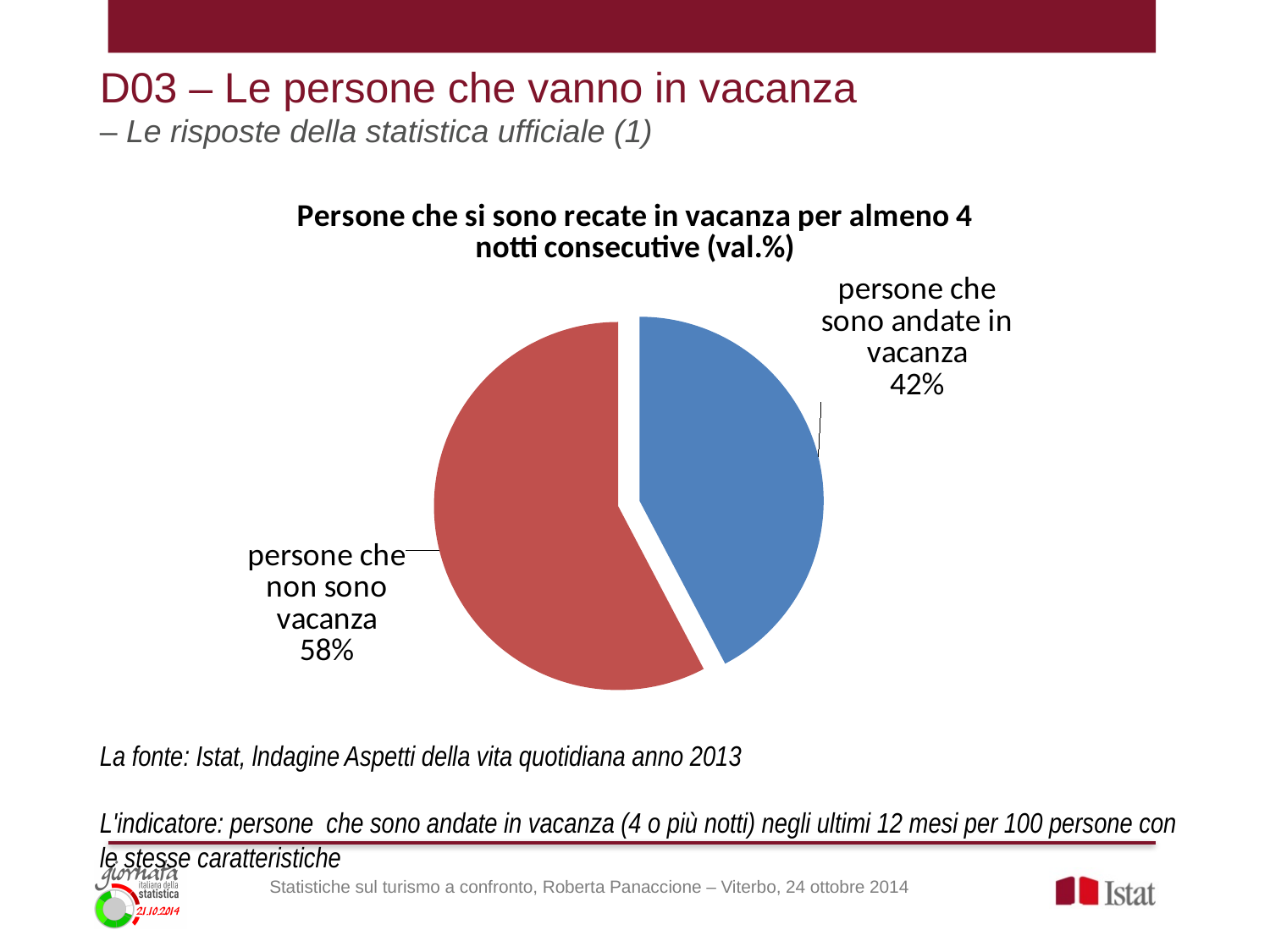
What colour is the slice for "persone che sono andate in vacanza"? blue Is the share for "persone che sono andate in vacanza" greater or less than 50%? less Which slice of the pie is the largest? persone che non sono vacanza What share of the pie is labelled "persone che sono andate in vacanza"? 42% Which is larger: the share of people who went on holiday or the share of people who did not? persone che non sono vacanza What is the total of the two slices shown in the pie chart? 100% What share of the pie is labelled "persone che non sono vacanza"? 58% What is the difference in percentage points between the two slices of the pie? 16 Which slice of the pie is the smallest? persone che sono andate in vacanza What kind of chart is shown on the slide? pie chart How many slices does the pie chart have? 2 What is the title of the chart? Persone che si sono recate in vacanza per almeno 4 notti consecutive (val.%)